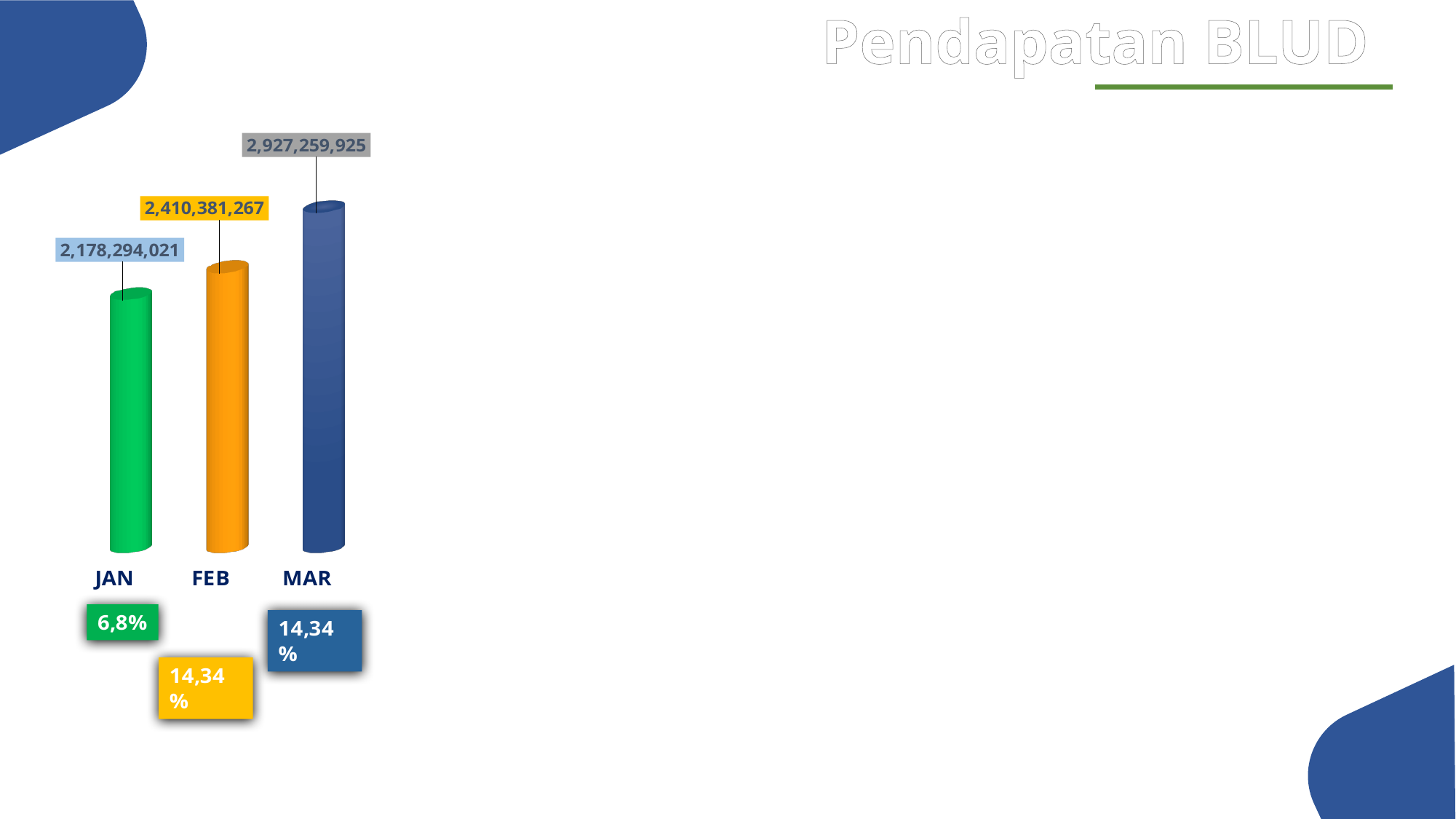
Do the values rise or fall from JAN to MAR? Rise What is the difference between the values for MAR and FEB? 516,878,658 What is the difference between the values for MAR and JAN? 748,965,904 Which month has the highest value? MAR What kind of chart is shown on the slide? Bar chart What is the value for FEB? 2,410,381,267 What is the value for MAR? 2,927,259,925 What is the difference between the values for FEB and JAN? 232,087,246 What is the value for JAN? 2,178,294,021 Which month has the lowest value? JAN Which is larger, the value for FEB or the value for MAR? MAR How many months are shown in the chart? 3